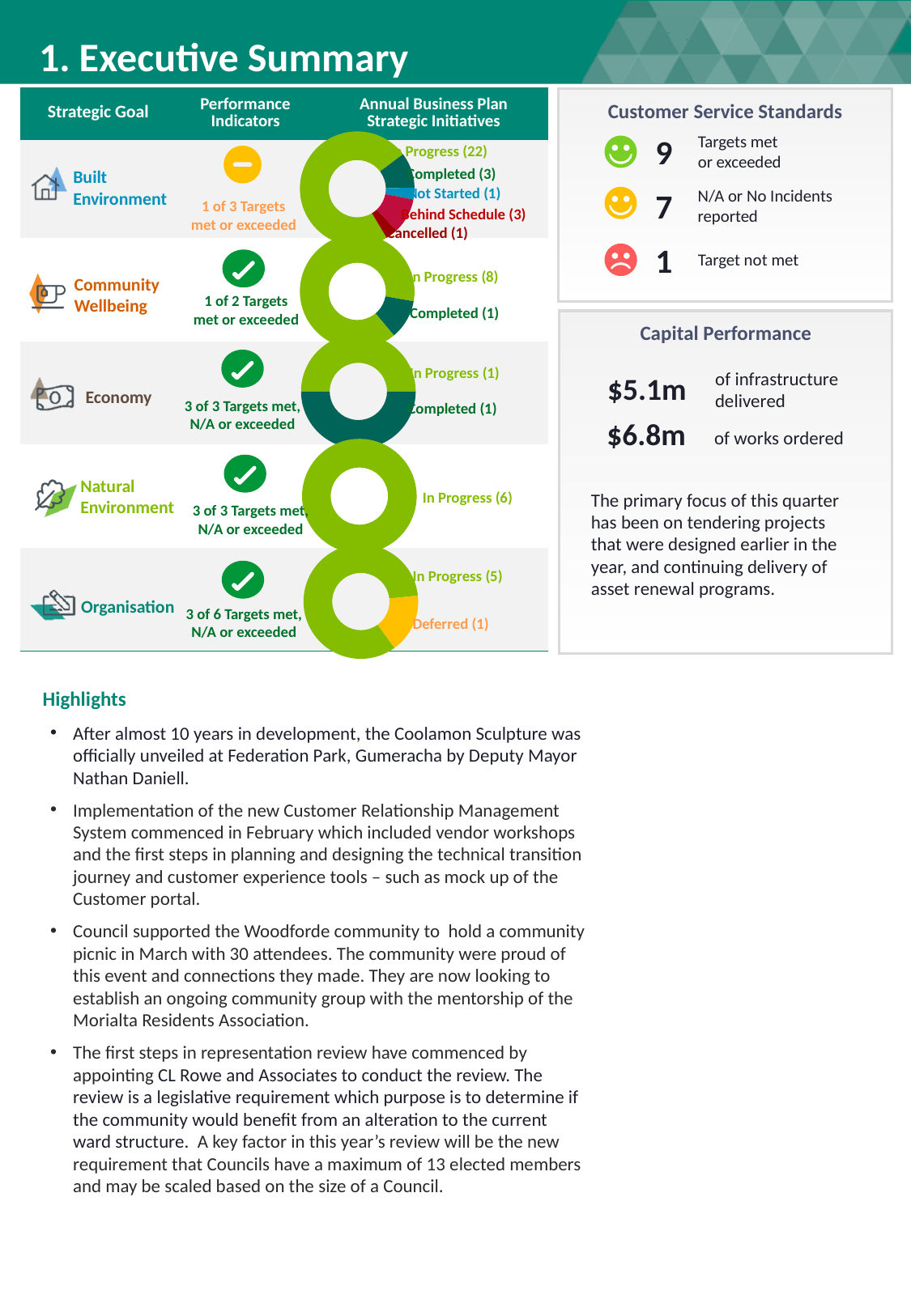
In the Built Environment donut chart, what is the total number of initiatives across all statuses? 30 In the Community Wellbeing donut chart, how many initiatives are In Progress? 8 In the Organisation donut chart, how many initiatives are Deferred? 1 In the Natural Environment donut chart, how many initiatives are In Progress? 6 In the Built Environment donut chart, how many status categories are shown? 5 What type of chart is used in the Annual Business Plan Strategic Initiatives column? Donut (pie) chart In the Economy donut chart, which is larger, In Progress or Completed? They are equal (1 each) In the Organisation donut chart, what share of initiatives are In Progress? 5 of 6 In the Built Environment donut chart, how many initiatives are In Progress? 22 In the Built Environment donut chart, which status has the largest number of initiatives? In Progress In the Built Environment donut chart, how many initiatives are Behind Schedule? 3 In the Community Wellbeing donut chart, what is the difference between In Progress and Completed initiatives? 7